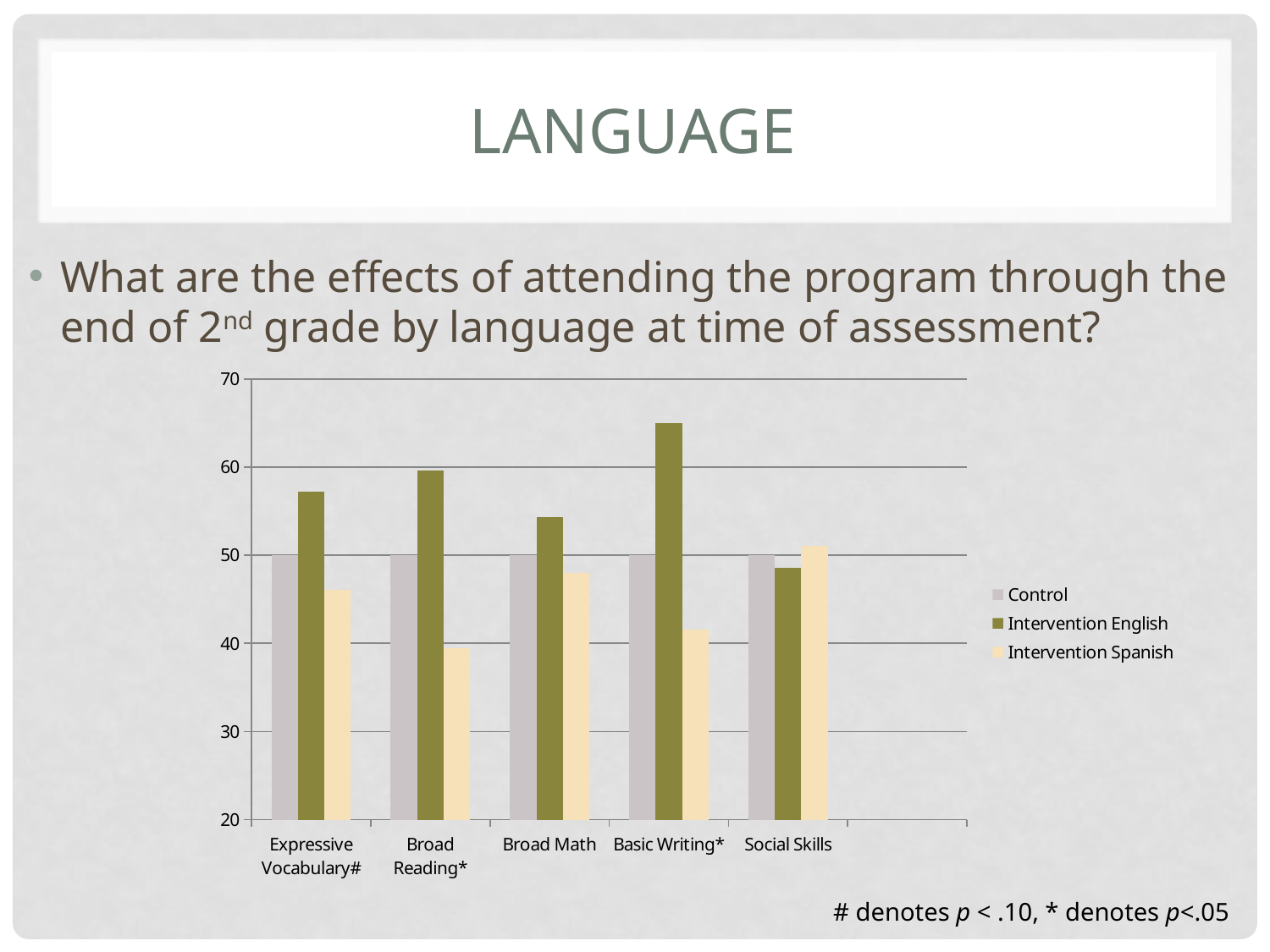
Is the Intervention Spanish value for Broad Reading* greater or less than 40? less How many series does the legend list? 3 For which category is the Intervention Spanish value lowest? Broad Reading* Is the Intervention English value for Basic Writing* greater or less than 60? greater For which category is the Intervention English value highest? Basic Writing* What kind of chart is shown on the slide? bar chart Which series is shown in dark olive green in the legend? Intervention English Which is larger for Social Skills: the Intervention English value or the Intervention Spanish value? Intervention Spanish What is the value of the Control series for Broad Math? 50 How many categories are shown on the x axis? 5 Which is larger for Expressive Vocabulary#: the Control value or the Intervention English value? Intervention English What is the value of the Control series for Social Skills? 50